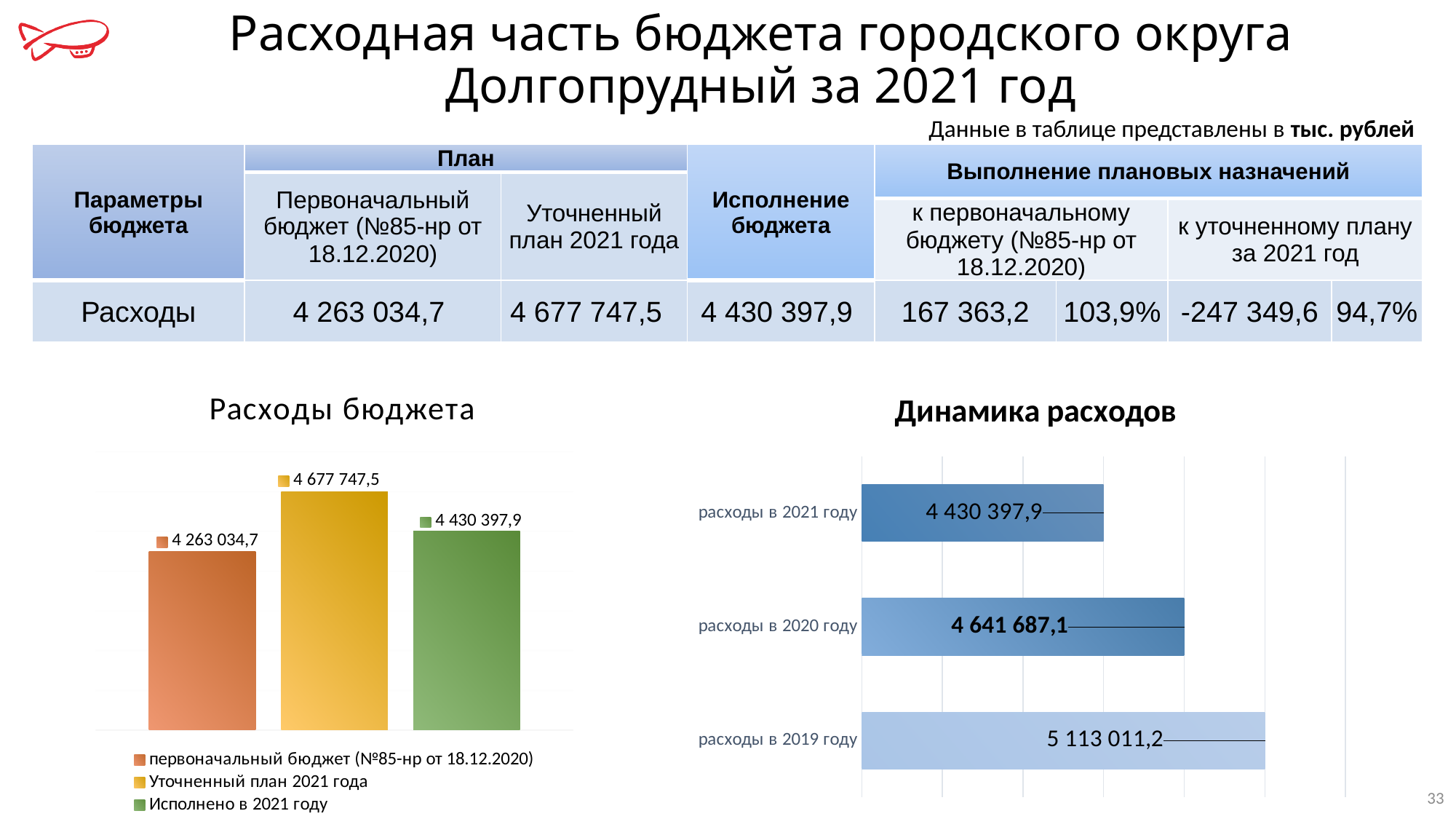
In the 'Динамика расходов' chart, do expenses rise or fall from 2019 to 2021? Fall What kind of chart is 'Динамика расходов'? Bar chart In the 'Расходы бюджета' chart, how many series does the legend list? 3 In the 'Динамика расходов' chart, what is the value for 'расходы в 2019 году'? 5 113 011,2 In the 'Динамика расходов' chart, which year has the highest expenses? расходы в 2019 году In the 'Расходы бюджета' chart, what is the difference between 'Уточненный план 2021 года' and 'Исполнено в 2021 году'? 247 349,6 In the 'Динамика расходов' chart, what is the value for 'расходы в 2020 году'? 4 641 687,1 In the 'Расходы бюджета' chart, which series has the lowest value? первоначальный бюджет (№85-нр от 18.12.2020) In the 'Расходы бюджета' chart, what is the value for 'Уточненный план 2021 года'? 4 677 747,5 In the 'Расходы бюджета' chart, what colour is the bar for 'Уточненный план 2021 года'? Yellow In the 'Расходы бюджета' chart, what is the value for 'Исполнено в 2021 году'? 4 430 397,9 In the 'Динамика расходов' chart, what is the difference between 'расходы в 2019 году' and 'расходы в 2020 году'? 471 324,1